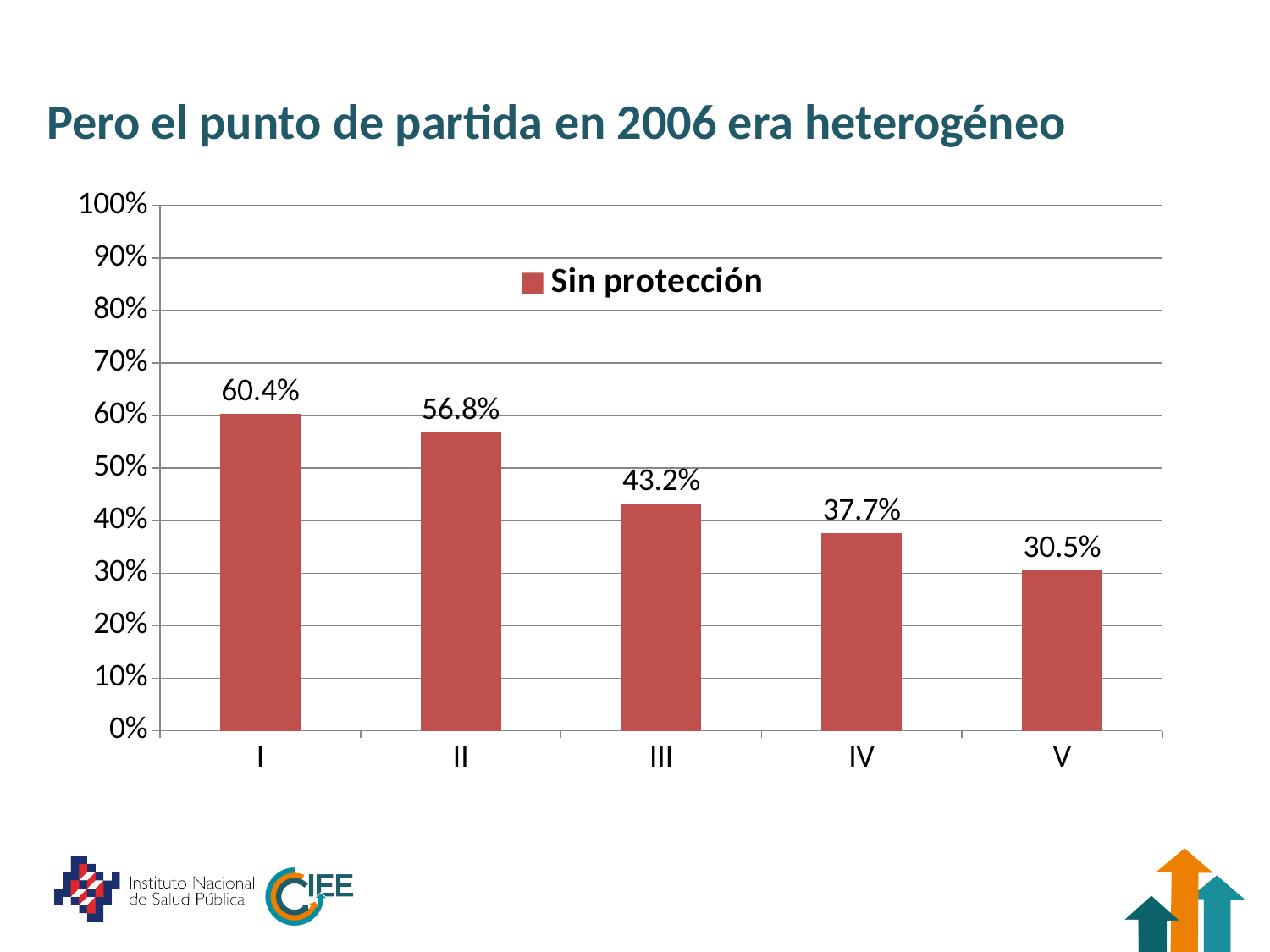
What is the value for category V? 30.5% What is the value for category I? 60.4% What kind of chart is shown on the slide? bar chart Which is larger, the value for category II or the value for category III? II Which category has the lowest value? V Do the values rise or fall from category I to category V? fall What is the difference between the values for category II and category IV? 19.1% Which category has the highest value? I Is the value for category IV greater or less than 40%? less What is the value for category III? 43.2% What is the difference between the values for category I and category V? 29.9% How many categories are shown on the x axis? 5